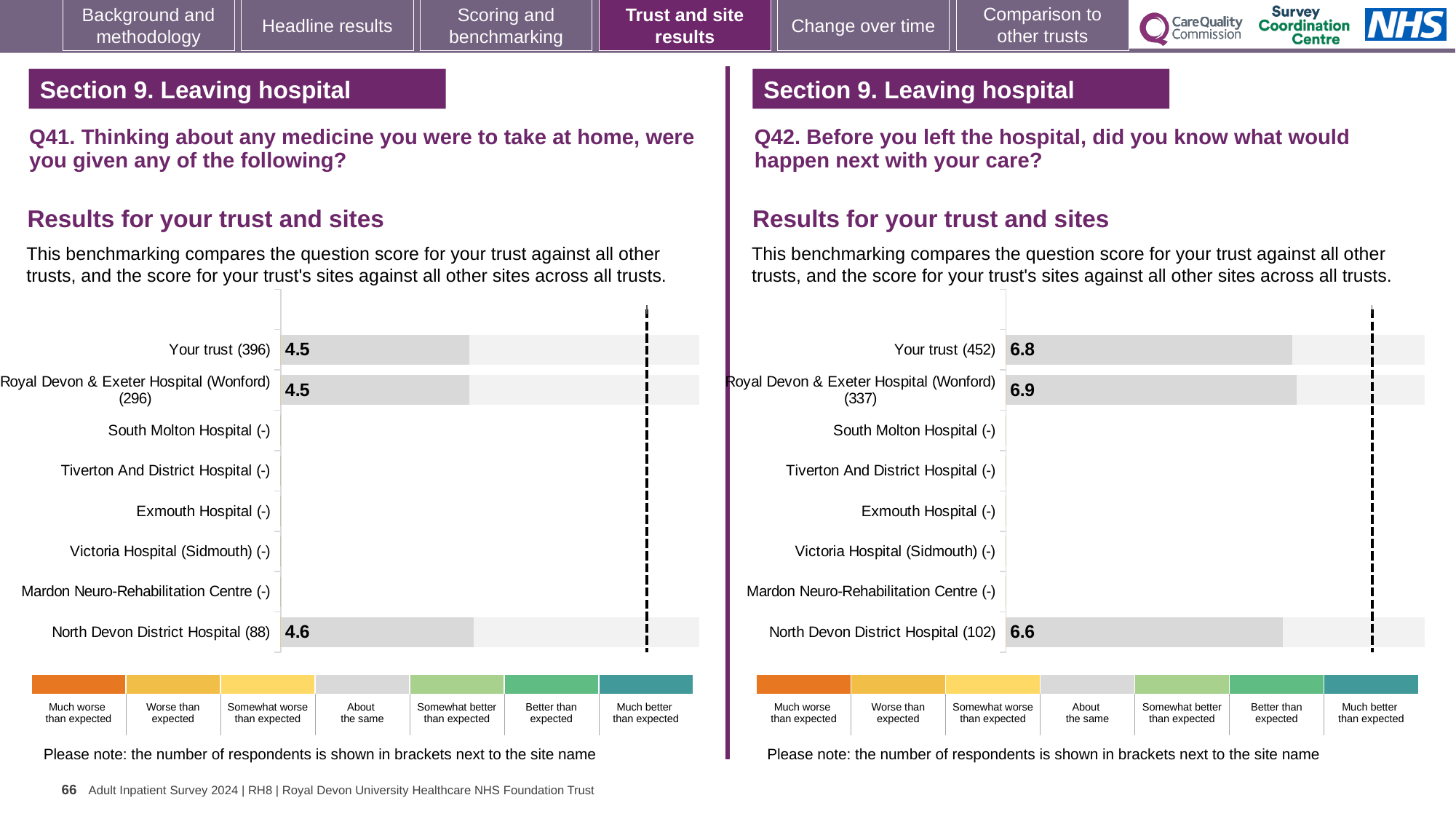
In the Q41 chart on the left, what is the score for Your trust (396)? 4.5 In the Q42 chart on the right, what is the score for Your trust (452)? 6.8 In the Q41 chart on the left, what is the difference between the scores for North Devon District Hospital and Your trust? 0.1 How many site or trust rows are listed on the Q41 chart on the left? 8 In the Q42 chart on the right, what is the score for North Devon District Hospital (102)? 6.6 In the Q42 chart on the right, what is the score for Royal Devon & Exeter Hospital (Wonford) (337)? 6.9 In the Q42 chart on the right, what is the difference between the scores for Royal Devon & Exeter Hospital (Wonford) and North Devon District Hospital? 0.3 In the Q41 chart on the left, what is the score for North Devon District Hospital (88)? 4.6 In the Q42 chart on the right, which site or trust row has the lowest score? North Devon District Hospital (102) In the Q42 chart on the right, which site or trust row has the highest score? Royal Devon & Exeter Hospital (Wonford) (337) What kind of chart is used for the Q42 results on the right? Bar chart In the Q42 chart on the right, which is larger: the score for Your trust or the score for North Devon District Hospital? Your trust